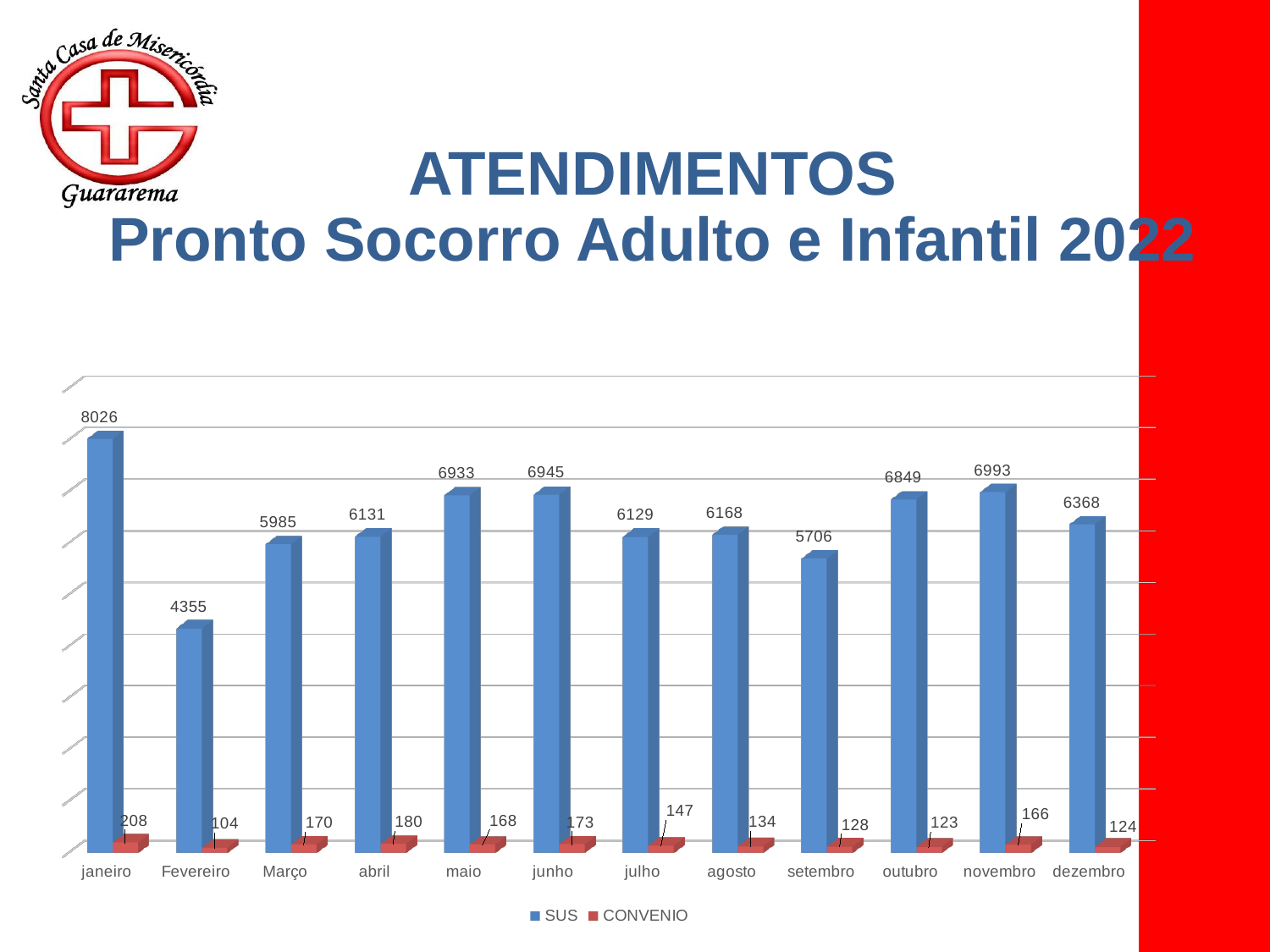
Which month has the lowest SUS value? Fevereiro How many series does the legend list? 2 Which month has the lowest CONVENIO value? Fevereiro Which is larger, the SUS value for novembro or the SUS value for outubro? novembro What kind of chart is shown on the slide? bar chart What is the SUS value for setembro? 5706 What is the difference between the SUS values for janeiro and Fevereiro? 3671 What is the difference between the CONVENIO values for janeiro and dezembro? 84 Which month has the highest SUS value? janeiro How many months are shown on the x axis? 12 What is the SUS value for janeiro? 8026 What is the CONVENIO value for julho? 147